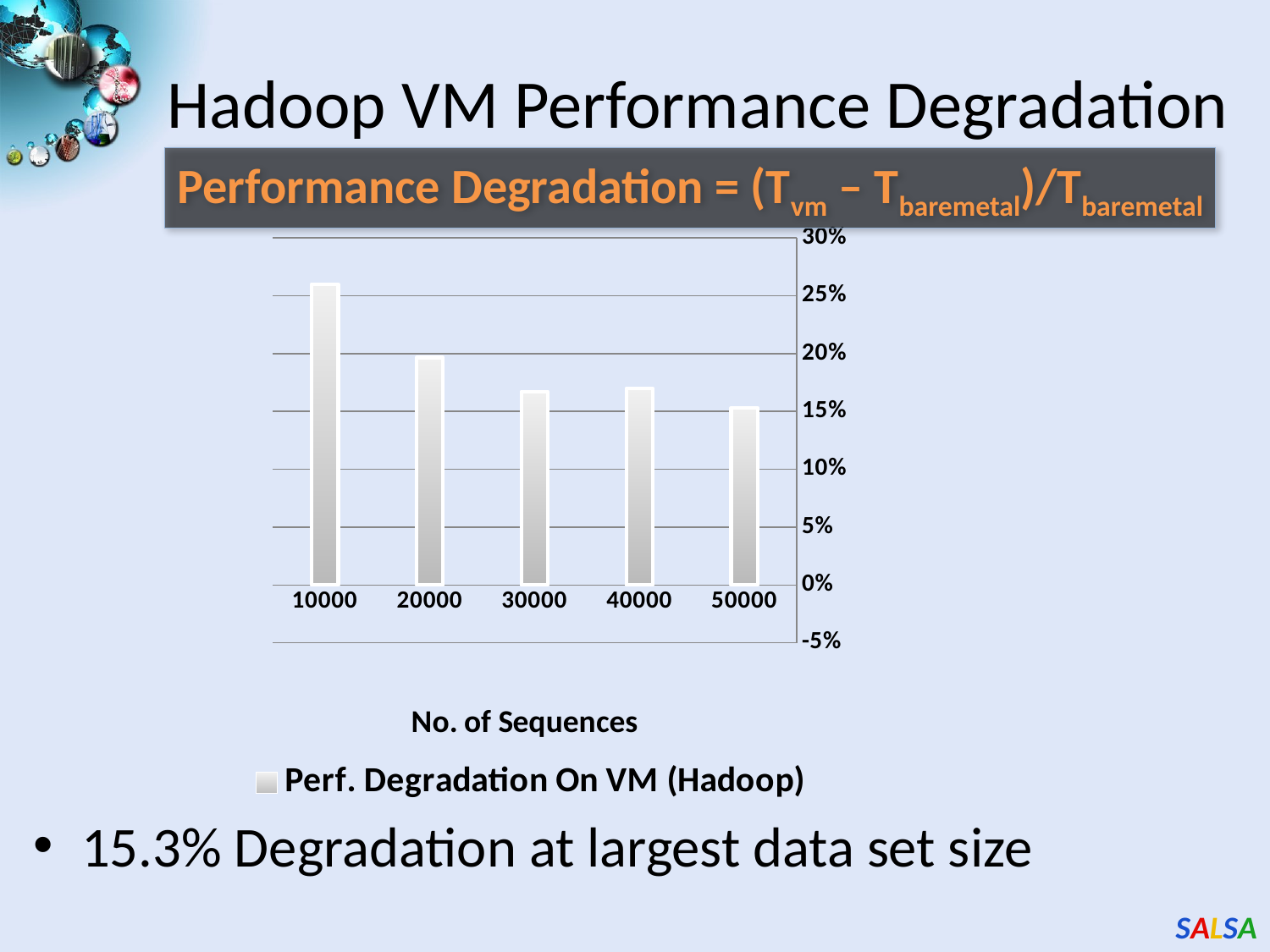
What is the name of the series shown in the legend? Perf. Degradation On VM (Hadoop) What is the performance degradation at the largest data set size (50000 sequences)? 15.3% Is the performance degradation for 10000 sequences greater or less than 25%? greater Which has a larger performance degradation, 10000 sequences or 20000 sequences? 10000 Which number of sequences has the highest performance degradation? 10000 What is the x-axis title of the chart? No. of Sequences How many series does the legend list? 1 How many categories (numbers of sequences) are plotted on the x axis? 5 What type of chart is shown on the slide? bar chart Does the performance degradation generally rise or fall as the number of sequences increases? fall Which number of sequences has the lowest performance degradation? 50000